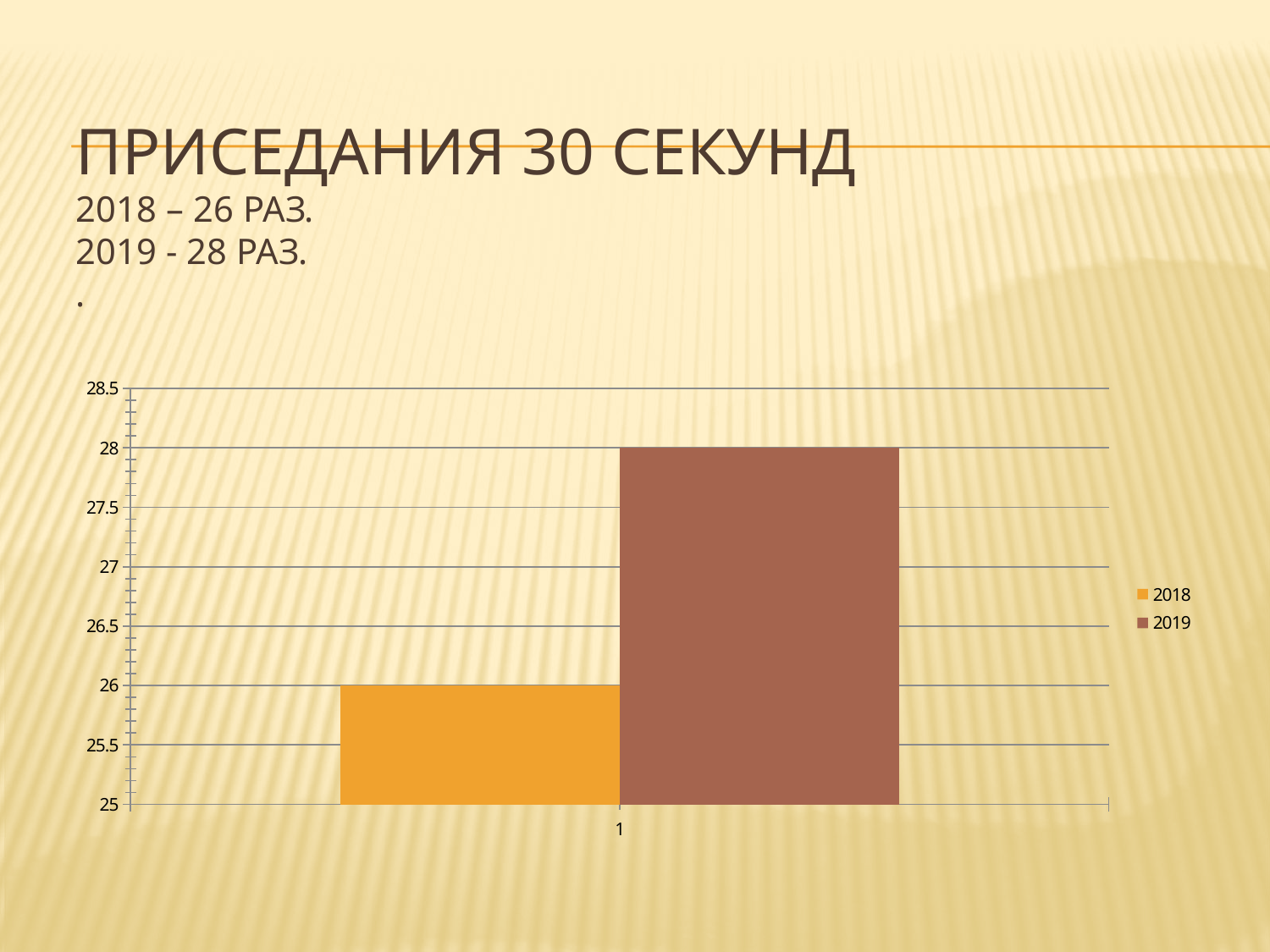
Which series has the shorter bar? 2018 Is the value for 2019 greater or less than 27? greater Is the value for 2018 larger or smaller than the value for 2019? smaller What is the difference between the 2019 value and the 2018 value? 2 How many series does the legend list? 2 Is the value for 2018 greater or less than 27? less What kind of chart is shown on the slide? bar chart What is the value of the 2019 bar? 28 How many categories are shown on the x axis? 1 What colour is the bar for the 2018 series? orange What is the value of the 2018 bar? 26 Which series has the taller bar, 2018 or 2019? 2019